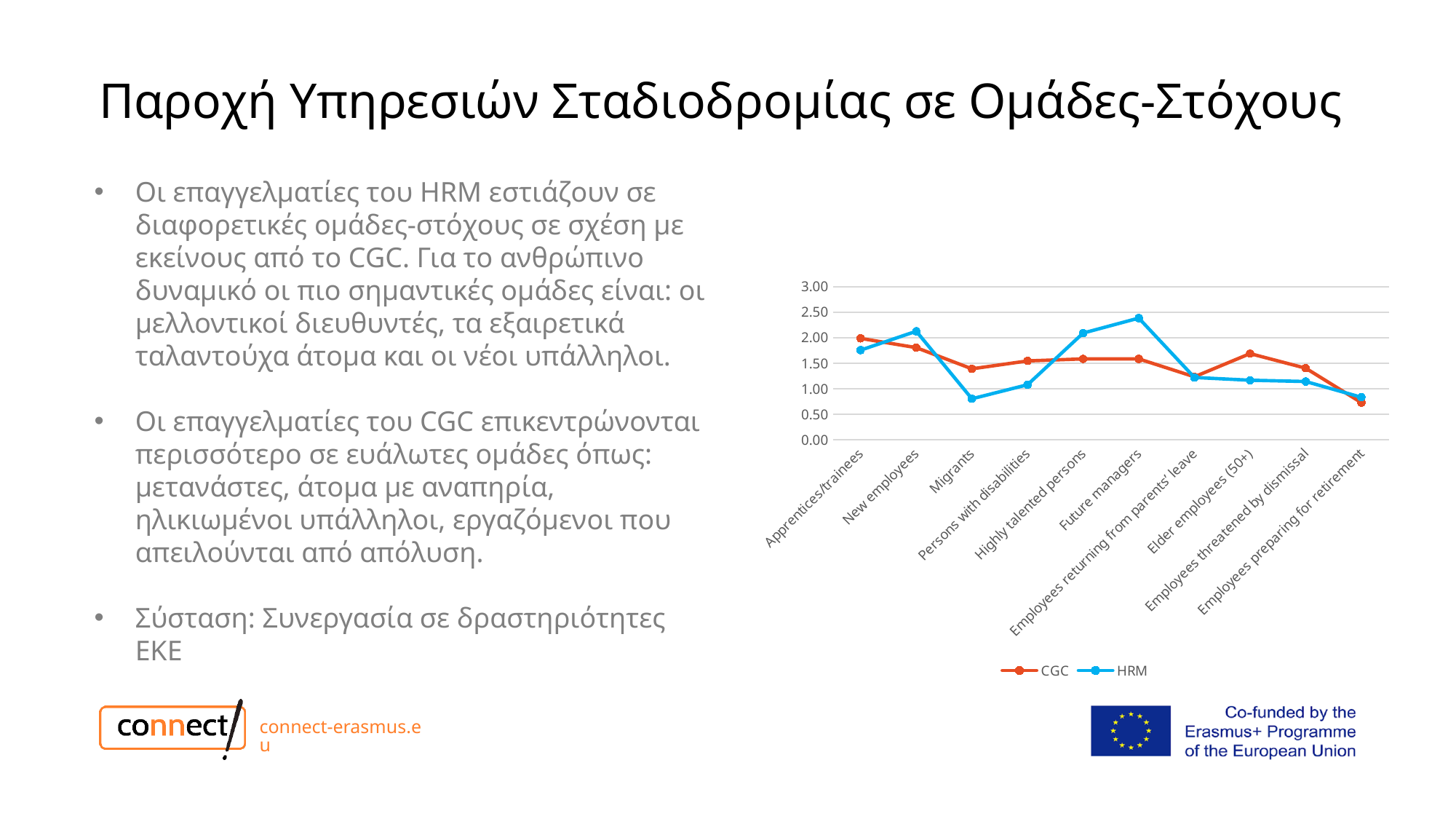
For Migrants, which series has the larger value, CGC or HRM? CGC Is the HRM value for Migrants greater or less than 1.00? less How many target groups (categories) are plotted along the x axis? 10 How many series does the chart legend list? 2 Is the HRM value for Future managers greater or less than 2.00? greater For which category does the HRM series reach its highest value? Future managers For which category does the CGC series have its lowest value? Employees preparing for retirement For Highly talented persons, which series has the larger value, CGC or HRM? HRM Is the CGC value for Elder employees (50+) greater or less than 1.50? greater What kind of chart is shown on the slide? line chart Which series is drawn in blue? HRM Does the CGC line rise or fall from Employees threatened by dismissal to Employees preparing for retirement? fall